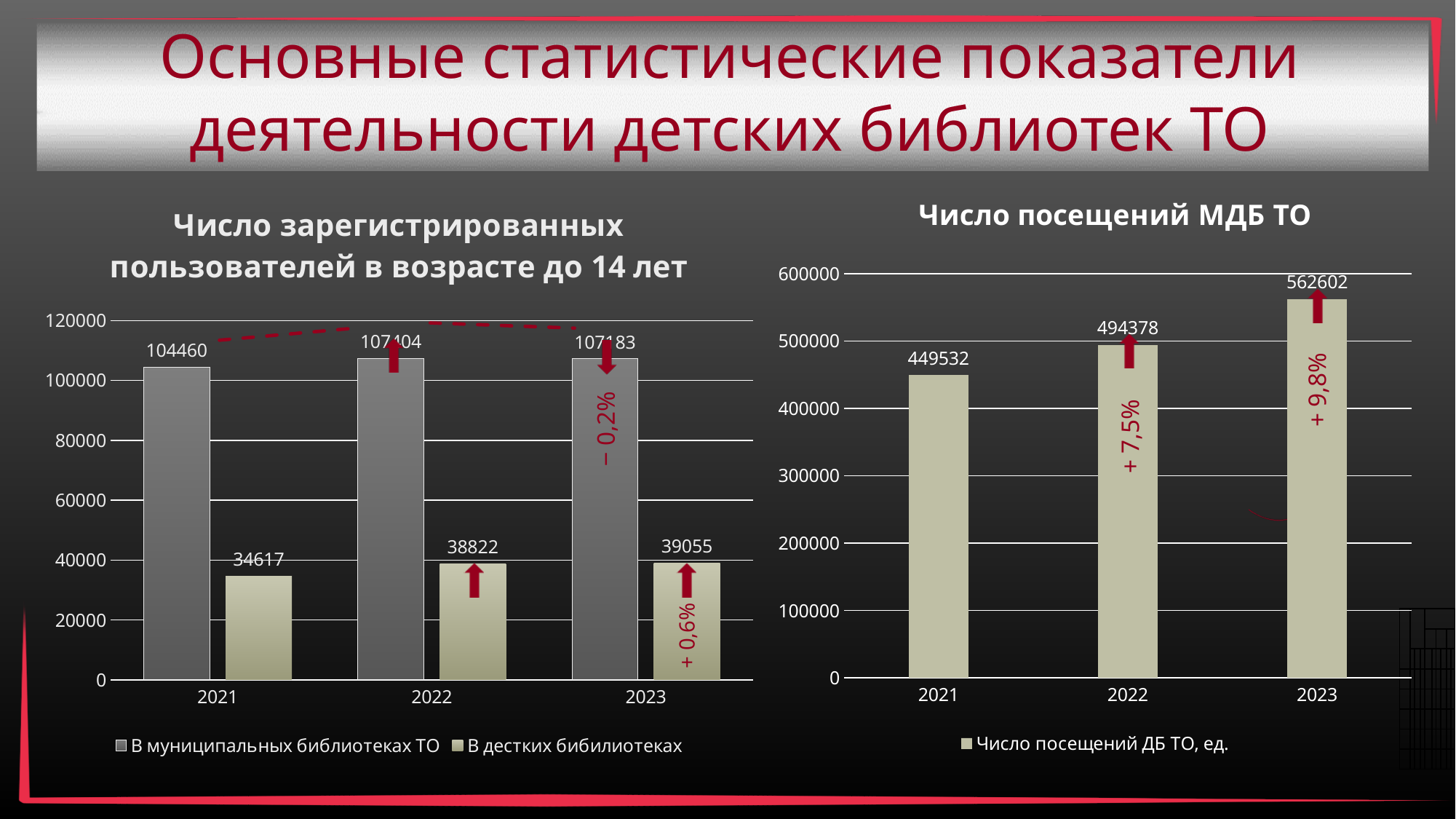
In the left chart on registered users under 14, what is the value for 'В дестких бибилиотеках' in 2021? 34617 In the chart 'Число посещений МДБ ТО', what is the value for 2021? 449532 How many series does the legend of the left chart on registered users under 14 list? 2 In the chart 'Число посещений МДБ ТО', what is the value for 2022? 494378 In the left chart on registered users under 14, which series has the larger value in 2022: 'В муниципальных библиотеках ТО' or 'В дестких бибилиотеках'? В муниципальных библиотеках ТО In the left chart on registered users under 14, what is the value for 'В дестких бибилиотеках' in 2023? 39055 In the chart 'Число посещений МДБ ТО', what is the difference between the 2023 and 2022 values? 68224 In the chart 'Число посещений МДБ ТО', what is the value for 2023? 562602 In the chart 'Число посещений МДБ ТО', do the values rise or fall from 2021 to 2023? rise In the chart 'Число посещений МДБ ТО', which year has the highest value? 2023 In the left chart on registered users under 14, what is the value for 'В муниципальных библиотеках ТО' in 2021? 104460 How many years are shown in the chart 'Число посещений МДБ ТО'? 3